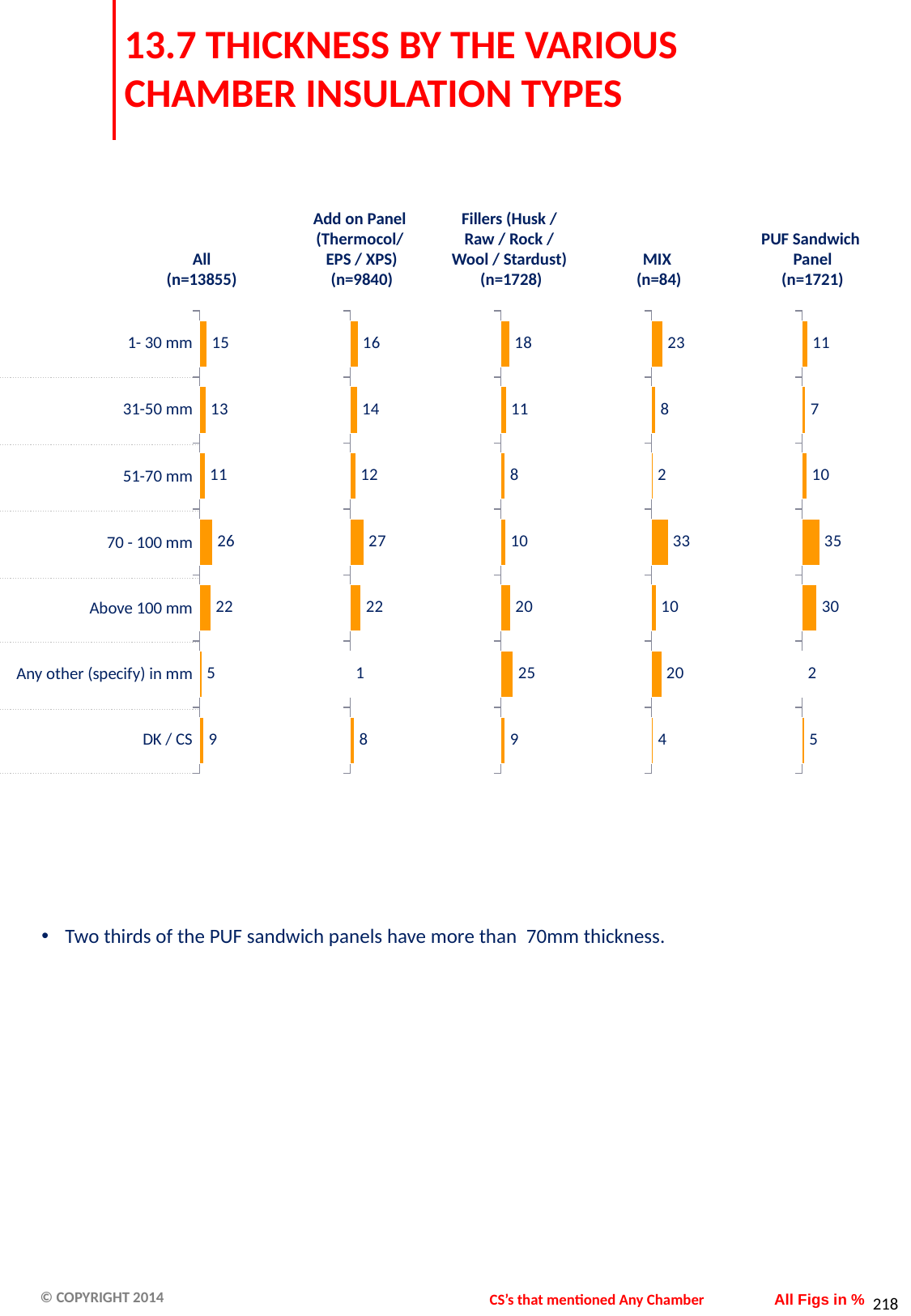
In the Fillers (Husk / Raw / Rock / Wool / Stardust) (n=1728) chart, what is the difference between the values for 1- 30 mm and 51-70 mm? 10 What type of chart is used for the MIX (n=84) data? Bar chart In the MIX (n=84) chart, which category has the highest value? 70 - 100 mm In the All (n=13855) chart, what is the value for 70 - 100 mm? 26 In the Add on Panel (Thermocol/ EPS / XPS) (n=9840) chart, which category has the lowest value? Any other (specify) in mm In the Fillers (Husk / Raw / Rock / Wool / Stardust) (n=1728) chart, which category has the highest value? Any other (specify) in mm How many categories are shown in the Add on Panel (Thermocol/ EPS / XPS) (n=9840) chart? 7 In the PUF Sandwich Panel (n=1721) chart, what is the value for Above 100 mm? 30 How many separate bar charts are shown on the slide? 5 In the MIX (n=84) chart, what is the value for 1- 30 mm? 23 In the All (n=13855) chart, which is larger: the value for 1- 30 mm or the value for 31-50 mm? 1- 30 mm In the PUF Sandwich Panel (n=1721) chart, what is the difference between the values for 70 - 100 mm and Above 100 mm? 5